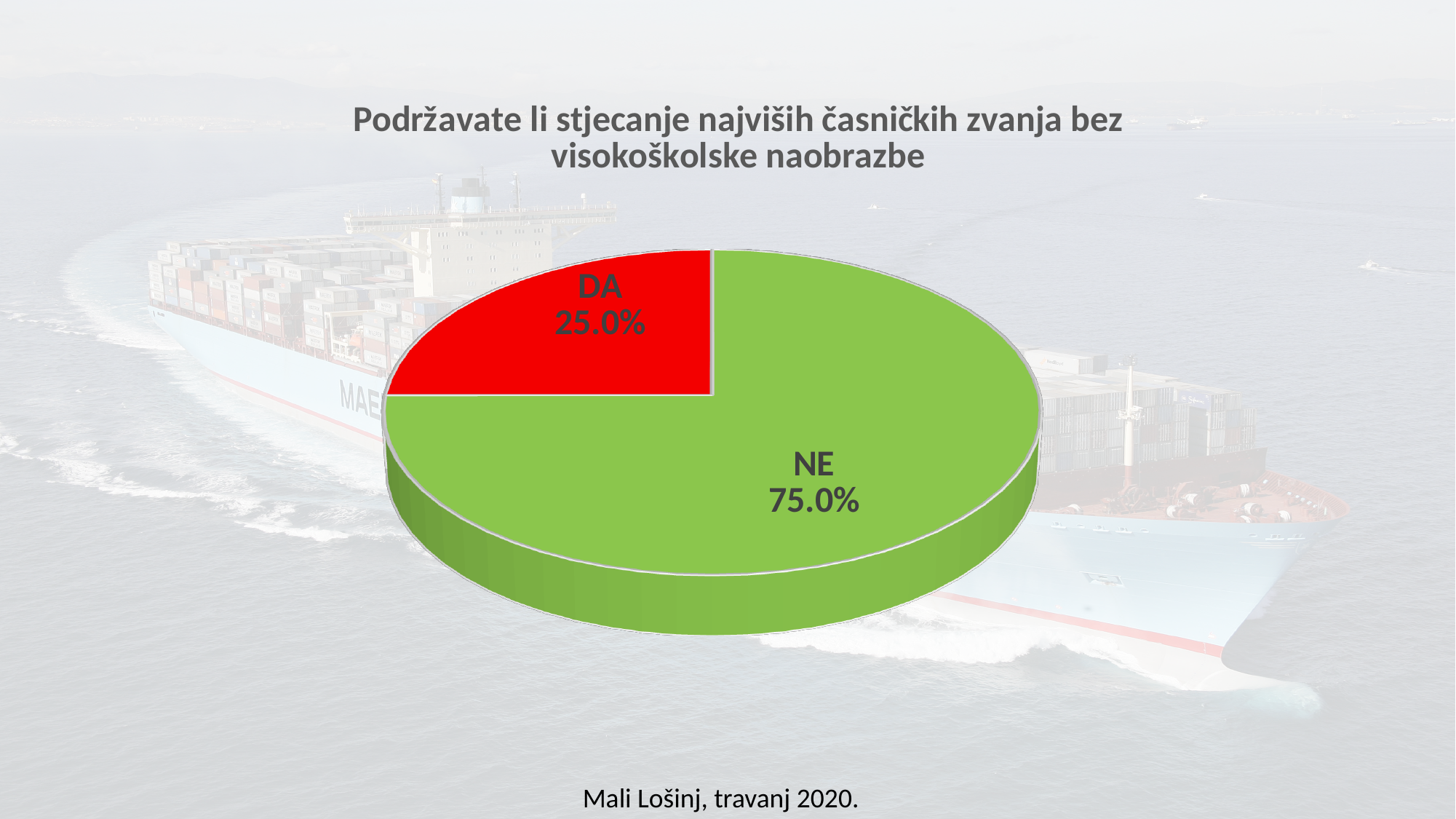
How many slices does the pie chart have? 2 What share of the pie does the DA slice represent? 25.0% Which is larger, DA or NE? NE What kind of chart is shown on the slide? pie chart Which slice is the largest? NE What is the title of the chart? Podržavate li stjecanje najviših časničkih zvanja bez visokoškolske naobrazbe Which slice is the smallest? DA What is the value for DA? 25.0% What is the value for NE? 75.0% What is the difference between the NE and DA values? 50.0% What colour is the NE slice? green